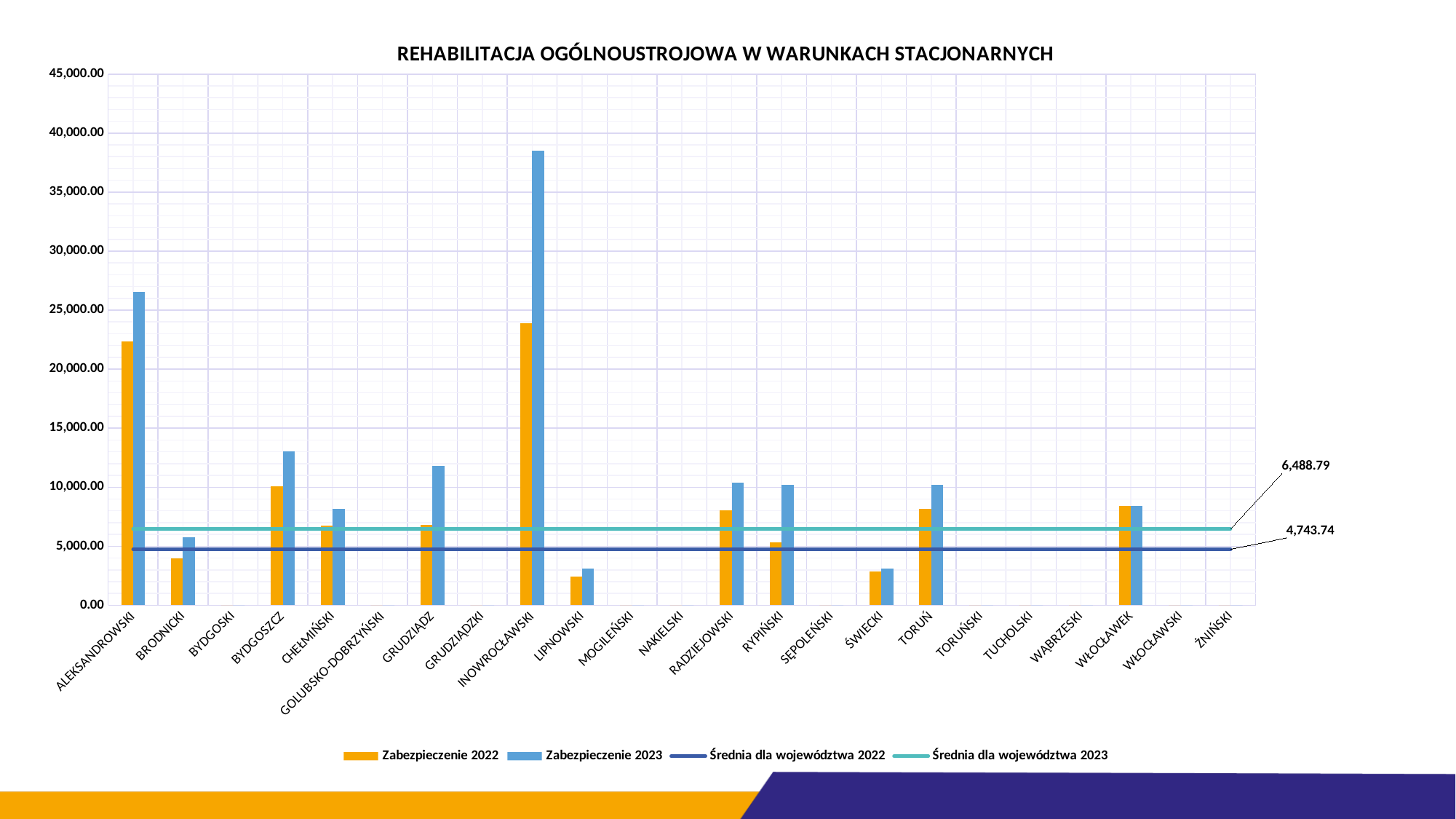
What colour represents the Zabezpieczenie 2022 series? orange Which category has the highest Zabezpieczenie 2022 value? INOWROCŁAWSKI Which is larger, the Zabezpieczenie 2023 value for ALEKSANDROWSKI or for BYDGOSZCZ? ALEKSANDROWSKI How many categories are shown on the x axis? 23 What is the difference between Średnia dla województwa 2023 and Średnia dla województwa 2022? 1,745.05 Which category has the highest Zabezpieczenie 2023 value? INOWROCŁAWSKI How many series does the legend list? 4 What is the value of Średnia dla województwa 2022? 4,743.74 Is the Zabezpieczenie 2023 value for INOWROCŁAWSKI greater or less than 35,000.00? greater Is the Zabezpieczenie 2022 value for BRODNICKI greater or less than 5,000.00? less What is the value of Średnia dla województwa 2023? 6,488.79 What kind of chart is shown on the slide? combination bar and line chart